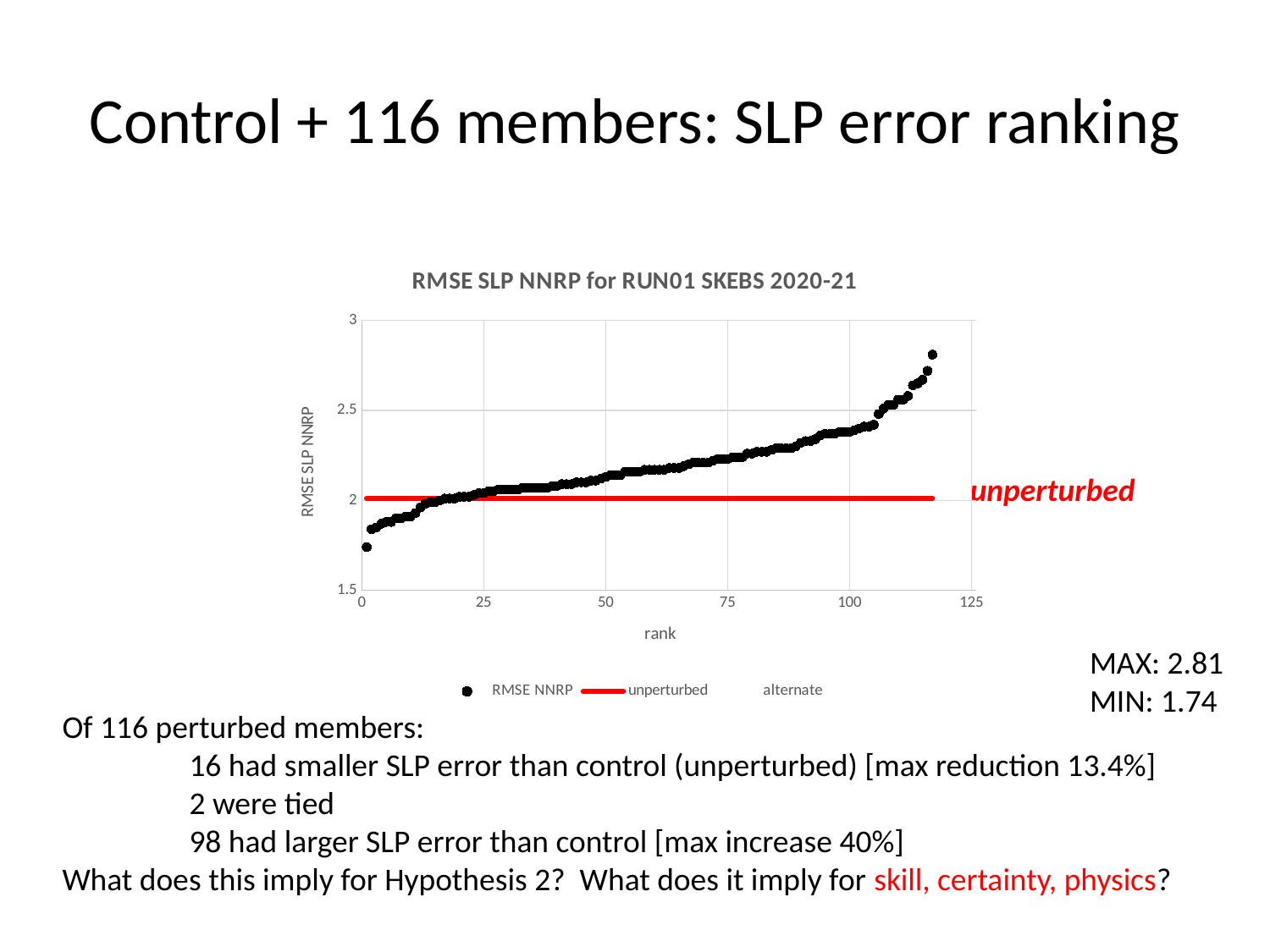
What is the difference between the stated MAX and MIN RMSE values? 1.07 What is the title of the chart? RMSE SLP NNRP for RUN01 SKEBS 2020-21 What is the minimum RMSE value stated on the slide? 1.74 Is the RMSE NNRP value at rank 100 greater or less than 2? greater How many perturbed members are plotted in the ranking? 116 What kind of chart is shown on the slide? scatter chart What is the label of the x axis of the chart? rank Is the RMSE NNRP value at rank 50 greater or less than 2.5? less Do the RMSE NNRP values rise or fall as rank increases along the x axis? rise What is the maximum RMSE value stated on the slide? 2.81 How many series does the chart legend list? 3